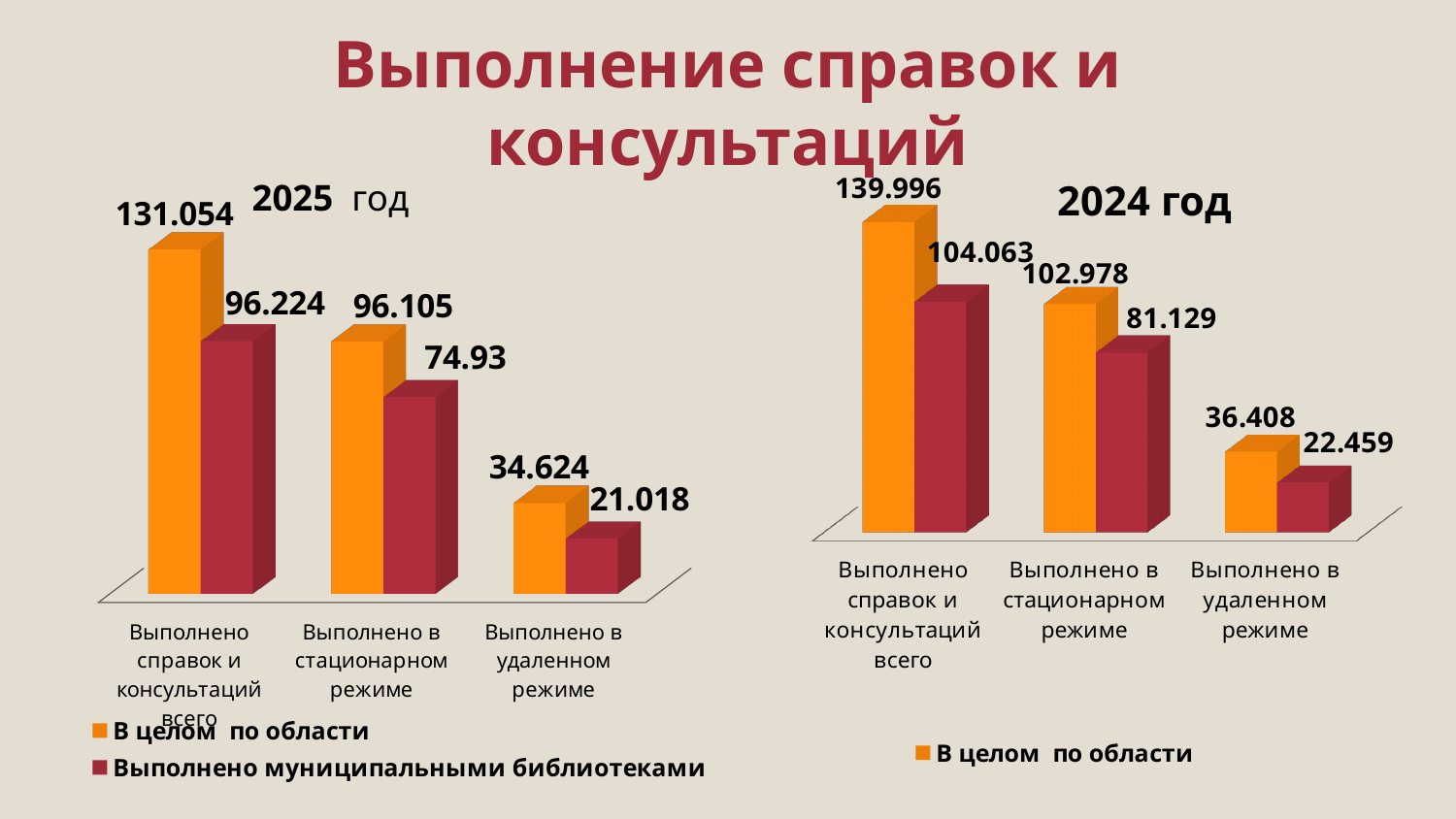
What type of chart is the 2024 год chart? Bar chart On the 2025 год chart, which category has the lowest value for 'В целом по области'? Выполнено в удаленном режиме On the 2025 год chart, what is the difference between the two bars in the category 'Выполнено справок и консультаций всего'? 34.83 On the 2025 год chart, what is the value for 'В целом по области' in the category 'Выполнено справок и консультаций всего'? 131.054 On the 2025 год chart, what is the value for 'Выполнено муниципальными библиотеками' in the category 'Выполнено в удаленном режиме'? 21.018 How many categories are shown on the x axis of the 2025 год chart? 3 On the 2024 год chart, what is the value of the red bar for 'Выполнено в удаленном режиме'? 22.459 How many series does the legend of the 2025 год chart list? 2 On the 2024 год chart, what is the difference between the orange and red bars for 'Выполнено в удаленном режиме'? 13.949 On the 2024 год chart, what is the value of the orange bar for 'Выполнено в стационарном режиме'? 102.978 Which is larger: the 'В целом по области' value for 'Выполнено в стационарном режиме' on the 2025 год chart or on the 2024 год chart? 2024 год On the 2024 год chart, which category has the highest value for 'В целом по области'? Выполнено справок и консультаций всего